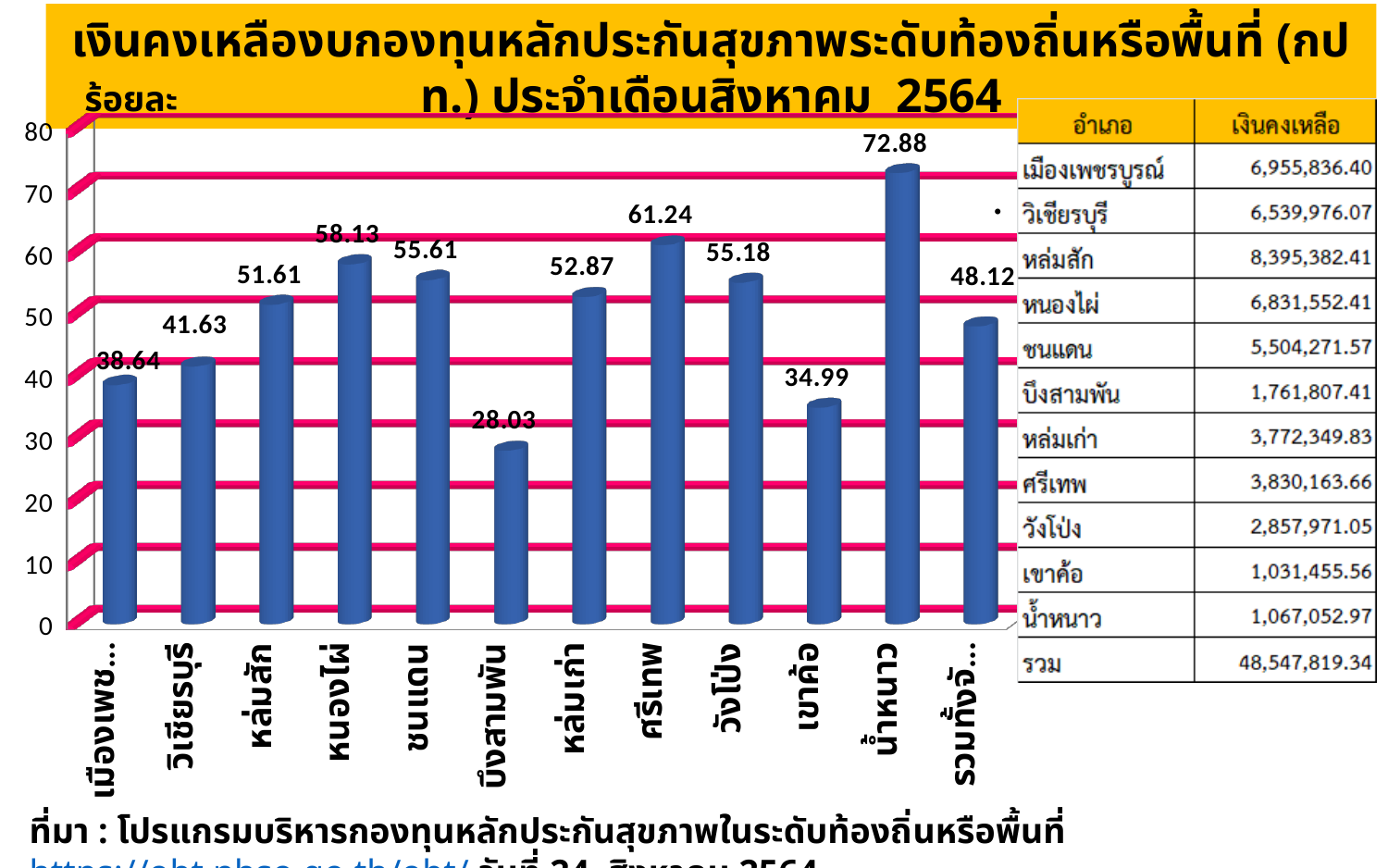
What is the difference between the values for ศรีเทพ and วังโป่ง in the bar chart? 6.06 Which category has the highest value in the bar chart? น้ำหนาว Which category has the lowest value in the bar chart? บึงสามพัน Which is larger in the bar chart, the value for หนองไผ่ or the value for ชนแดน? หนองไผ่ What kind of chart is shown on the slide? bar chart What is the value for เขาค้อ in the bar chart? 34.99 What is the value for น้ำหนาว in the bar chart? 72.88 Is the value for วิเชียรบุรี in the bar chart greater or less than 50? less What is the value for บึงสามพัน in the bar chart? 28.03 What is the value for หล่มสัก in the bar chart? 51.61 What is the label on the vertical axis of the bar chart? ร้อยละ How many bars are shown in the bar chart? 12